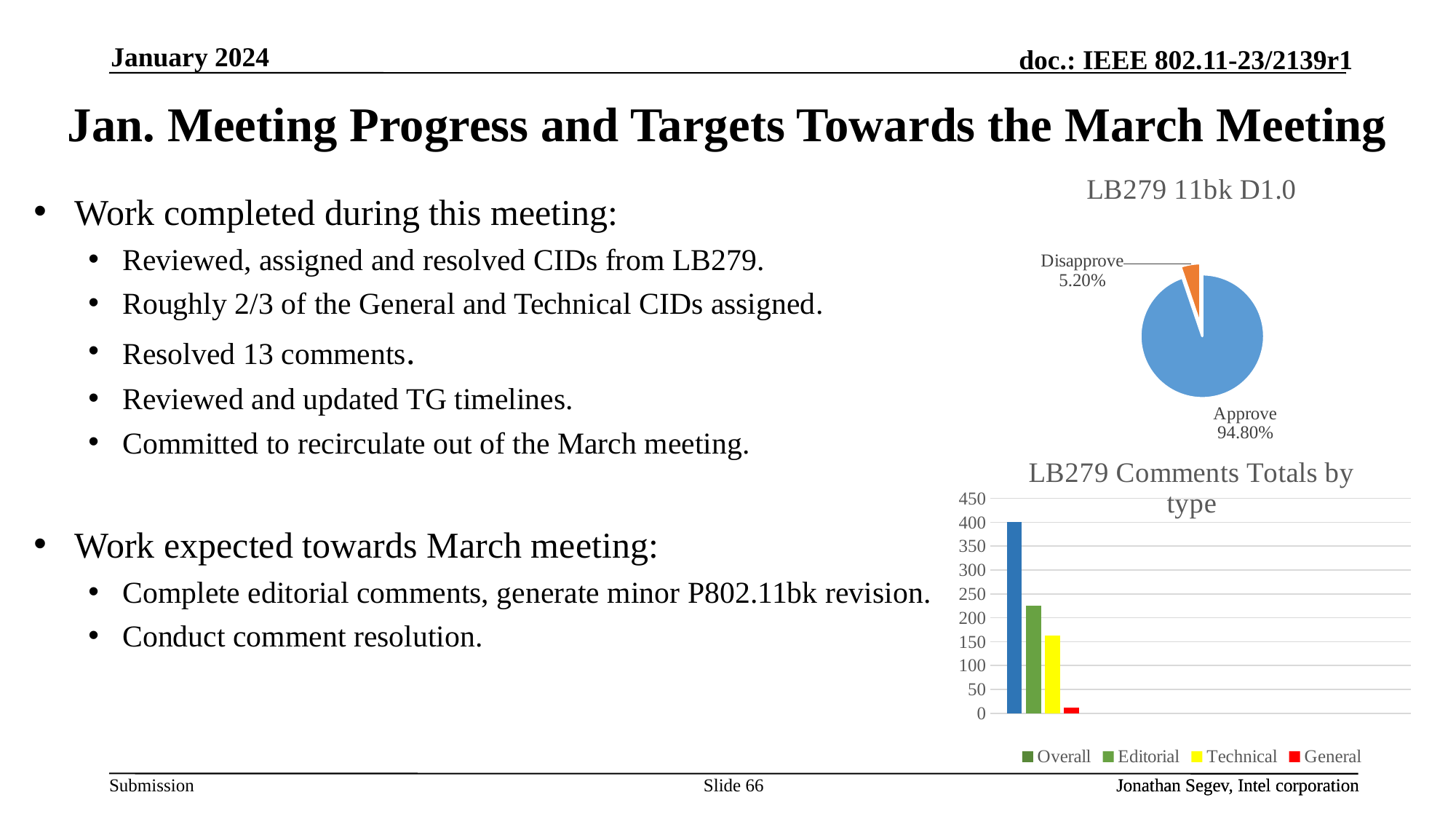
In the LB279 Comments Totals by type chart, which is larger, Editorial or Technical? Editorial How many slices does the LB279 11bk D1.0 pie chart have? 2 In the LB279 11bk D1.0 pie chart, what share of the pie is Disapprove? 5.20% In the LB279 11bk D1.0 pie chart, what share of the pie is Approve? 94.80% How many series does the legend of the LB279 Comments Totals by type chart list? 4 What kind of chart is the LB279 11bk D1.0 chart? pie chart What kind of chart is the LB279 Comments Totals by type chart? bar chart In the LB279 Comments Totals by type chart, which series has the lowest value? General In the LB279 Comments Totals by type chart, is the value for Overall greater or less than 350? greater In the LB279 Comments Totals by type chart, which series has the highest value? Overall In the LB279 11bk D1.0 pie chart, which slice is larger, Approve or Disapprove? Approve In the LB279 Comments Totals by type chart, is the value for Editorial greater or less than 250? less